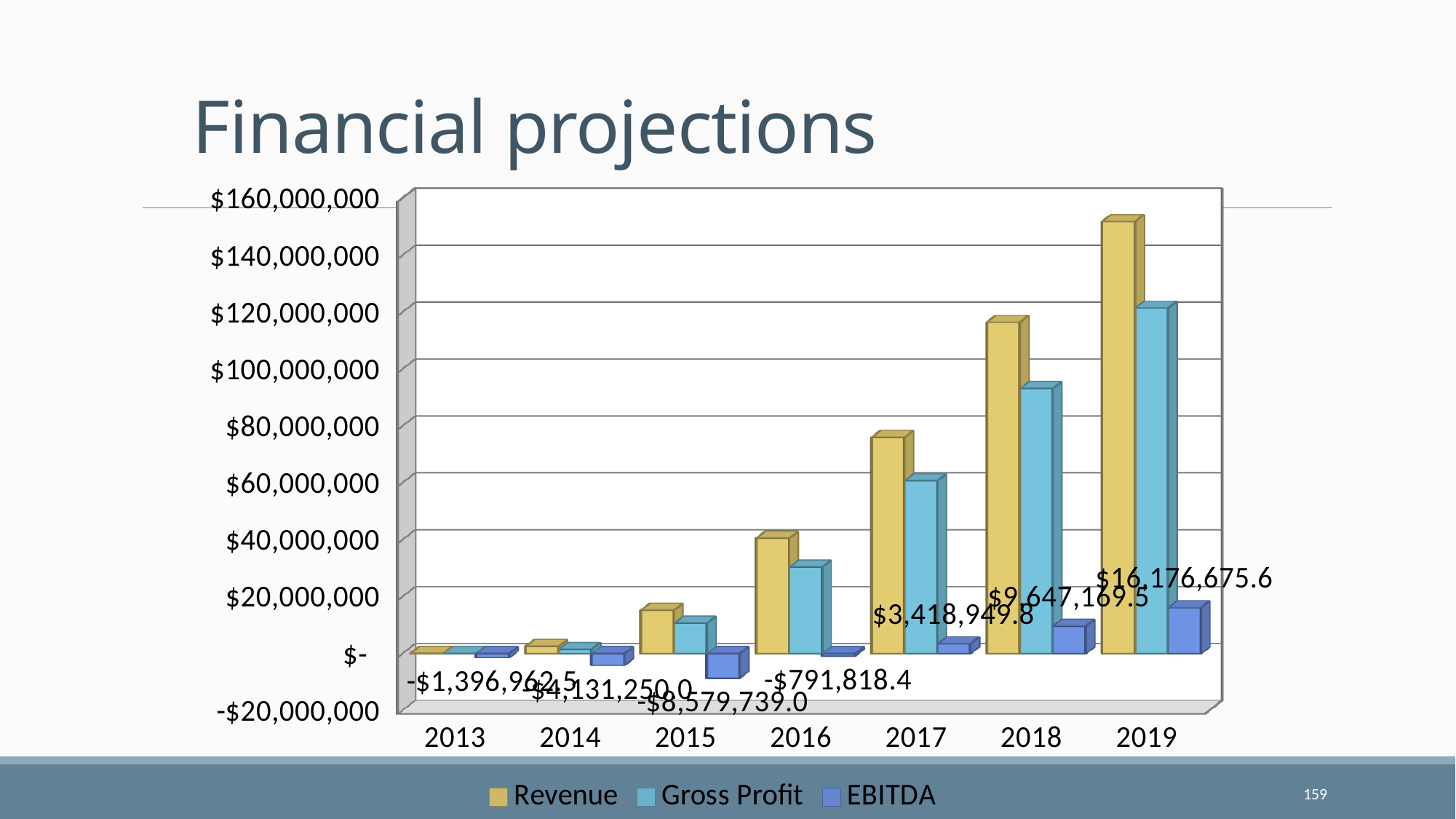
What is the EBITDA value for 2019? $16,176,675.6 What is the EBITDA value for 2017? $3,418,949.8 How many series does the legend list? 3 Is the Gross Profit value for 2018 greater or less than $80,000,000? greater Is the Revenue value for 2019 greater or less than $140,000,000? greater Is EBITDA larger in 2018 or in 2017? 2018 How many years are shown on the x axis? 7 Which year has the highest EBITDA? 2019 What is the EBITDA value for 2015? -$8,579,739.0 What kind of chart is shown on the slide? Bar chart What is the EBITDA value for 2013? -$1,396,962.5 Which year has the lowest EBITDA? 2015